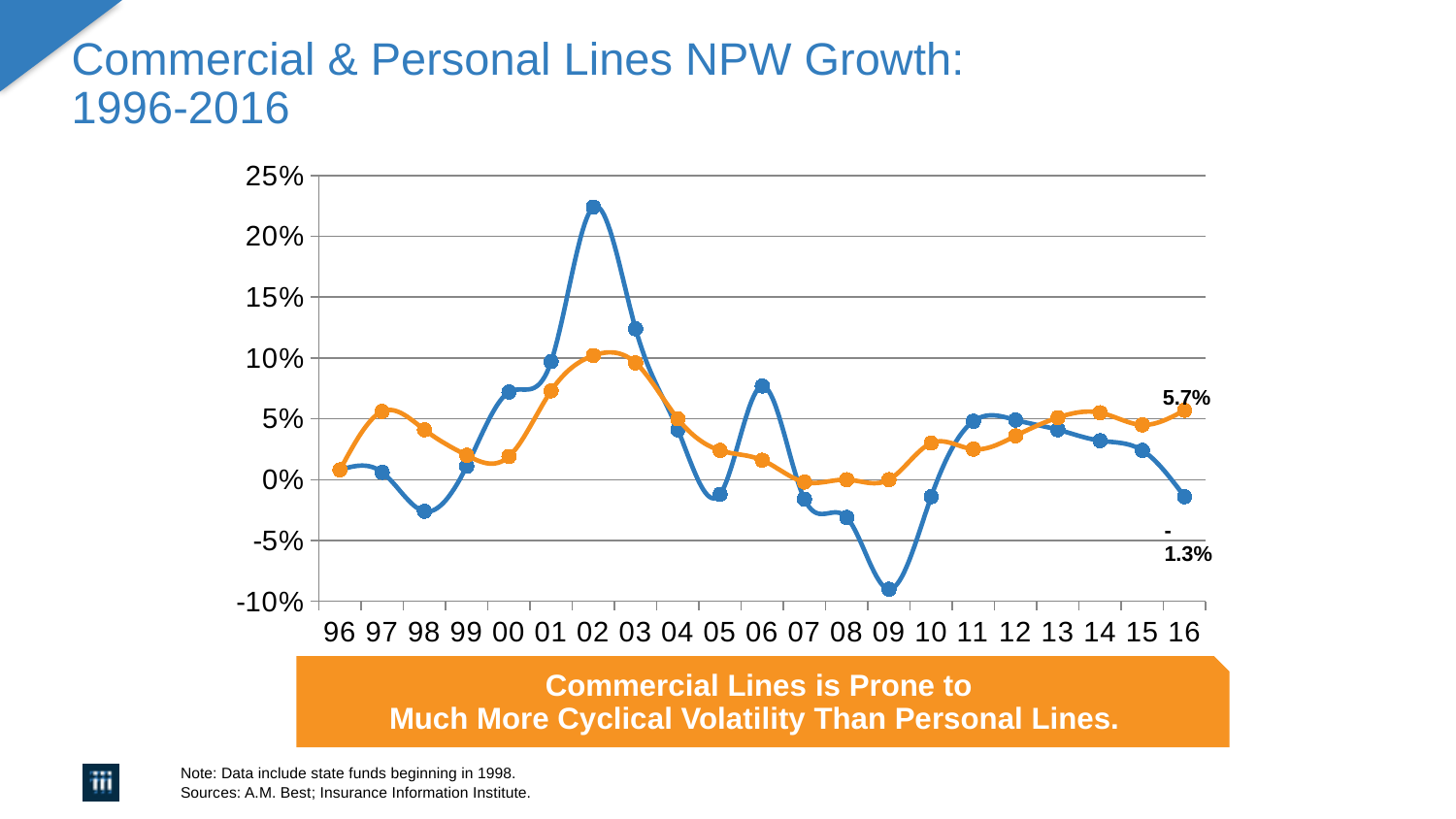
How many years are shown on the x axis? 21 What is the value of the blue line in 16? -1.3% What is the difference between the orange line and the blue line in 16? 7.0% In 16, which line has the higher value, the blue line or the orange line? orange line Does the blue line rise or fall from 13 to 16? fall What kind of chart is shown on the slide? line chart Is the value of the blue line in 02 greater or less than 20%? greater In which year does the blue line reach its highest value? 02 Is the value of the blue line in 09 greater or less than -5%? less In which year does the blue line reach its lowest value? 09 What is the value of the orange line in 16? 5.7% What is the title of the chart? Commercial & Personal Lines NPW Growth: 1996-2016